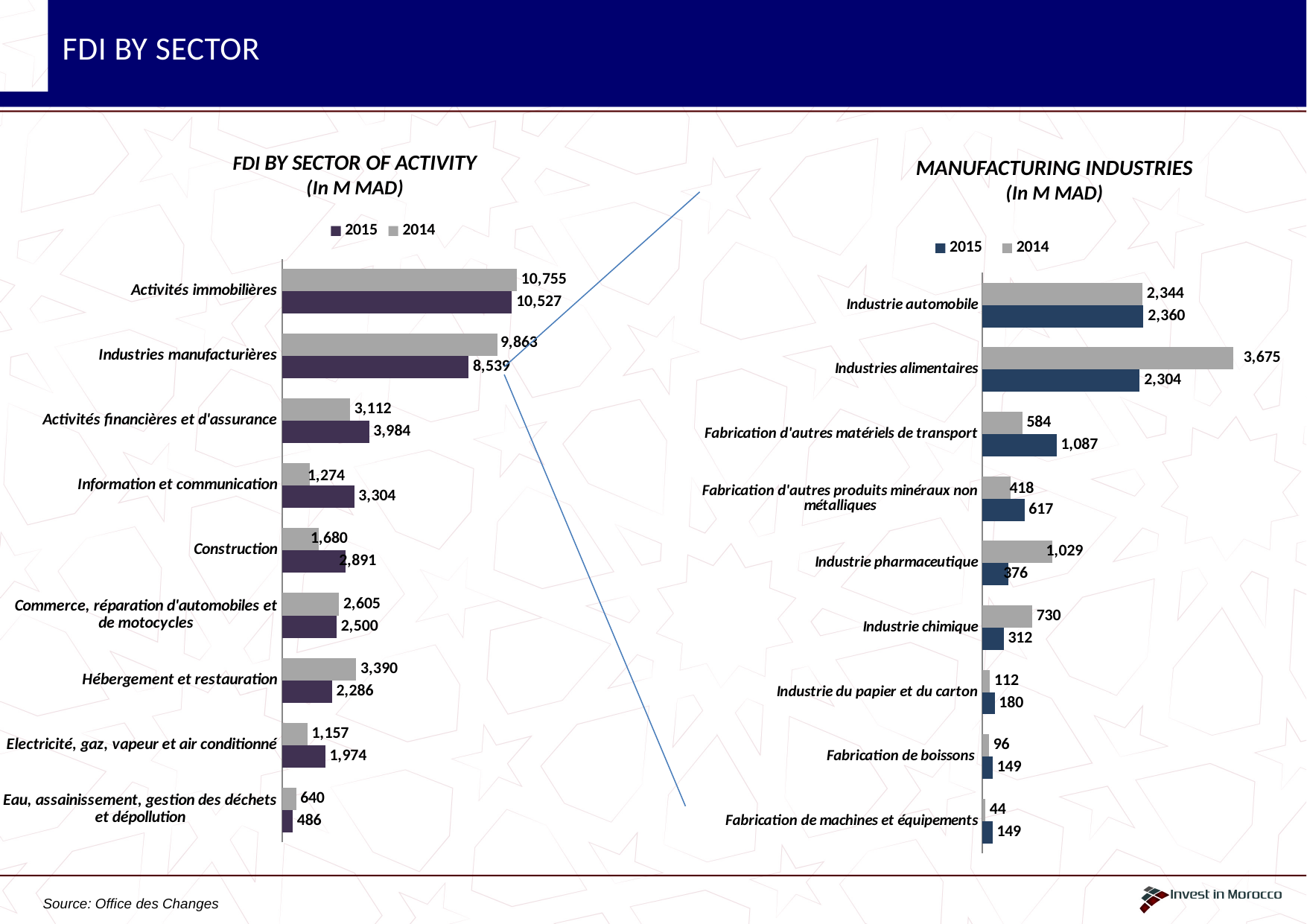
In the FDI BY SECTOR OF ACTIVITY chart, what is the 2014 value for Hébergement et restauration? 3,390 In the MANUFACTURING INDUSTRIES chart, which industry has the highest 2015 value? Industrie automobile In the FDI BY SECTOR OF ACTIVITY chart, what is the 2015 value for Activités immobilières? 10,527 How many sectors are shown in the FDI BY SECTOR OF ACTIVITY chart? 9 In the FDI BY SECTOR OF ACTIVITY chart, which is larger for Construction: the 2014 value or the 2015 value? 2015 In the MANUFACTURING INDUSTRIES chart, what is the 2015 value for Fabrication d'autres matériels de transport? 1,087 In the FDI BY SECTOR OF ACTIVITY chart, what is the difference between the 2014 and 2015 values for Information et communication? 2,030 How many series does the legend of the MANUFACTURING INDUSTRIES chart list? 2 What type of chart is the MANUFACTURING INDUSTRIES chart? Bar chart In the MANUFACTURING INDUSTRIES chart, what is the 2014 value for Industries alimentaires? 3,675 In the MANUFACTURING INDUSTRIES chart, what is the difference between the 2014 and 2015 values for Industrie pharmaceutique? 653 In the FDI BY SECTOR OF ACTIVITY chart, which sector has the lowest 2015 value? Eau, assainissement, gestion des déchets et dépollution